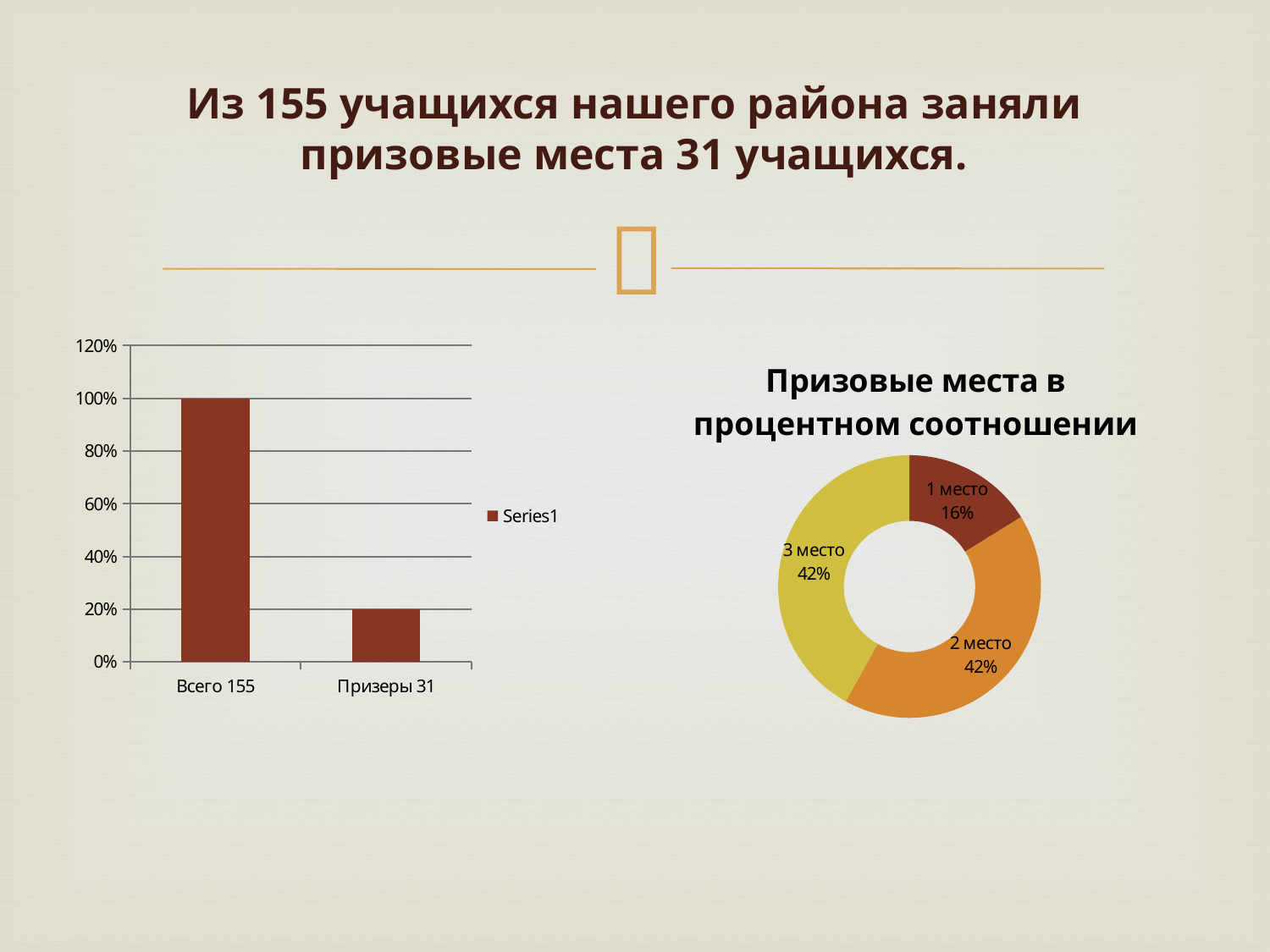
On the left bar chart, which category has the lower value? Призеры 31 On the chart titled 'Призовые места в процентном соотношении', what is the difference between the shares of 3 место and 1 место? 26% On the chart titled 'Призовые места в процентном соотношении', what share does 2 место have? 42% On the left bar chart, how many categories are shown on the x axis? 2 On the left bar chart, what entry does the legend list? Series1 What kind of chart is the chart on the left of the slide? Bar chart On the chart titled 'Призовые места в процентном соотношении', which slice is the smallest? 1 место On the left bar chart, what is the value for Призеры 31? 20% On the chart titled 'Призовые места в процентном соотношении', what share does 1 место have? 16% On the left bar chart, what is the value for Всего 155? 100% On the left bar chart, what is the difference between the values for Всего 155 and Призеры 31? 80% On the chart titled 'Призовые места в процентном соотношении', how many slices are there? 3